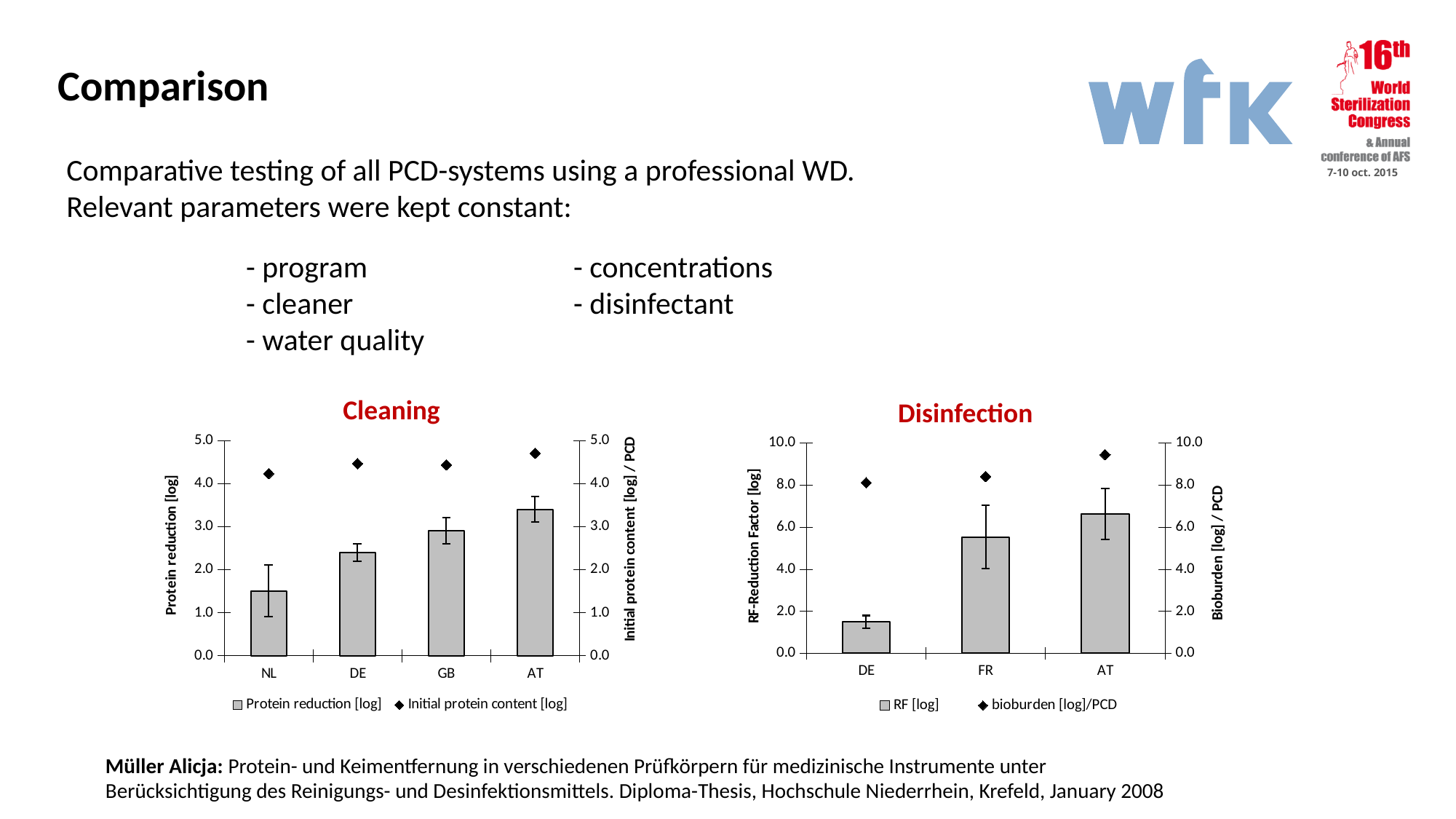
On the Cleaning chart, do the protein reduction bars rise or fall from NL to AT? rise On the Cleaning chart, how many series does the legend list? 2 On the Cleaning chart, which category has the lowest protein reduction? NL On the Disinfection chart, is the RF value for DE greater or less than 2.0? less On the Cleaning chart, is the protein reduction for NL greater or less than 2.0? less On the Cleaning chart, is the protein reduction for AT greater or less than 3.0? greater On the Cleaning chart, how many categories are shown on the x axis? 4 On the Disinfection chart, which category has the highest RF-Reduction Factor? AT On the Disinfection chart, which has the larger RF value, FR or DE? FR On the Cleaning chart, what kind of chart is used to show protein reduction? bar chart On the Disinfection chart, how many categories are shown on the x axis? 3 On the Cleaning chart, which category has the highest protein reduction? AT